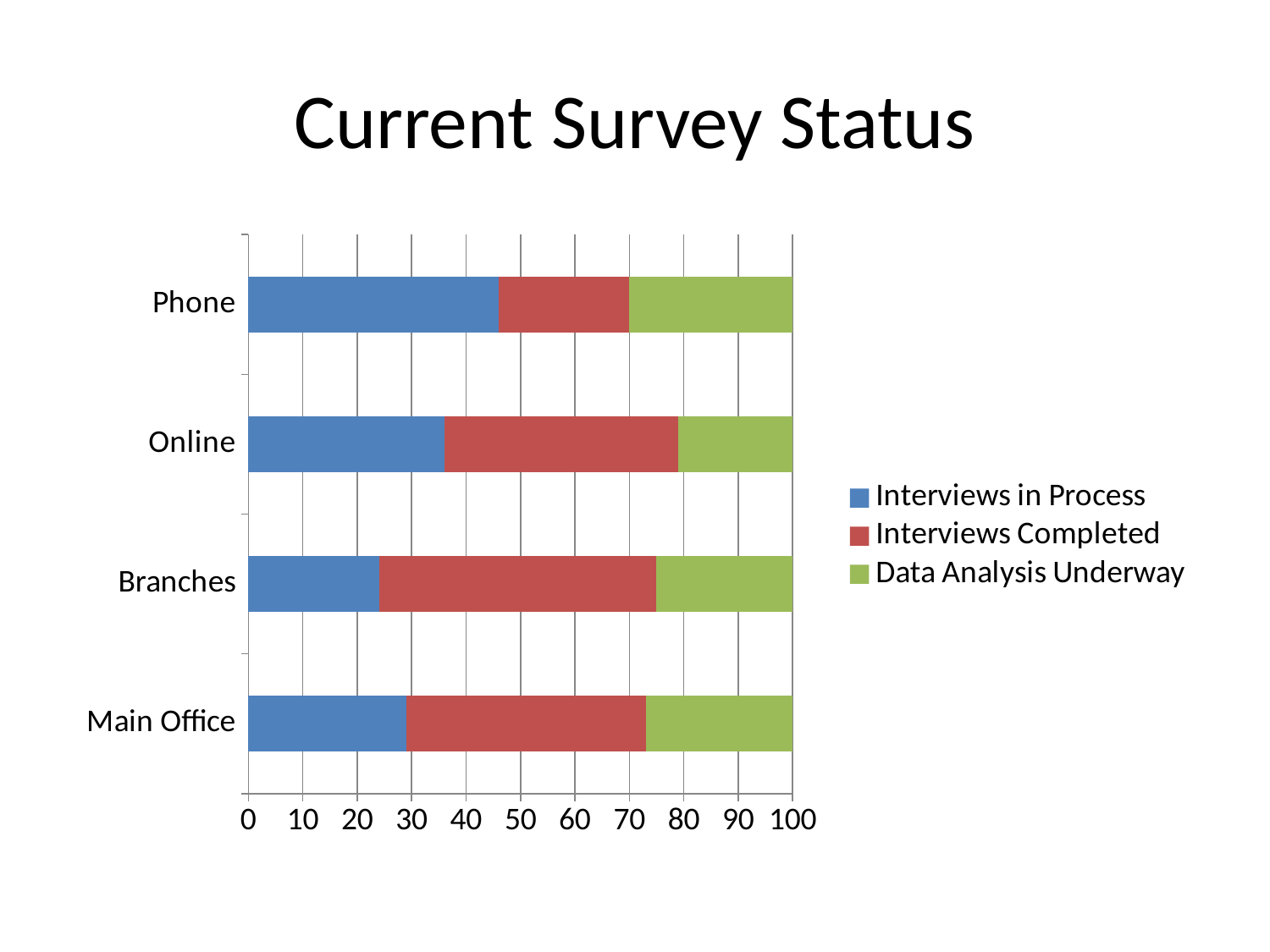
Is the Interviews in Process value for Phone greater or less than 40? greater What is the title of the chart? Current Survey Status Is the Interviews Completed segment larger for Branches or for Phone? Branches How many categories are shown on the vertical axis of the chart? 4 Which category has the largest Interviews in Process segment? Phone Is the Data Analysis Underway value for Online greater or less than 30? less Which category has the smallest Interviews in Process segment? Branches How many series does the legend list? 3 Is the Interviews in Process value for Branches greater or less than 30? less What is the total of the stacked bar for Main Office? 100 What kind of chart is shown on the slide? Stacked bar chart Which series is shown in green in the chart? Data Analysis Underway